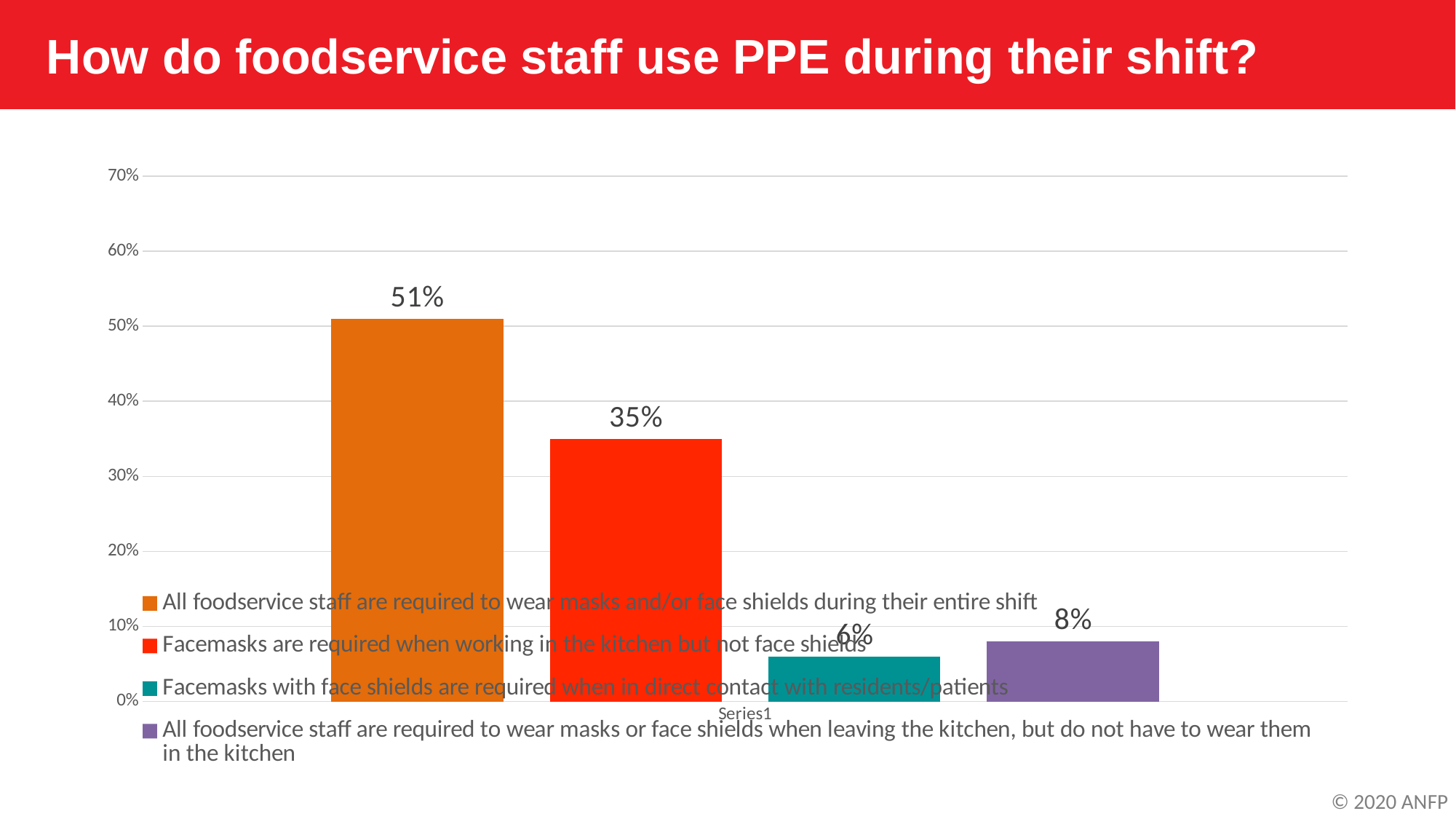
Is the value for 'Facemasks are required when working in the kitchen but not face shields' greater or less than 30%? greater What percentage of respondents said all foodservice staff are required to wear masks and/or face shields during their entire shift? 51% Which PPE practice has the lowest percentage? Facemasks with face shields are required when in direct contact with residents/patients What percentage of respondents said facemasks with face shields are required when in direct contact with residents/patients? 6% What colour is the bar for 'Facemasks with face shields are required when in direct contact with residents/patients'? Teal What percentage of respondents said all foodservice staff are required to wear masks or face shields when leaving the kitchen, but do not have to wear them in the kitchen? 8% What percentage of respondents said facemasks are required when working in the kitchen but not face shields? 35% Which PPE practice has the highest percentage? All foodservice staff are required to wear masks and/or face shields during their entire shift Which is larger: the percentage for masks required when leaving the kitchen only, or the percentage for facemasks with face shields in direct contact with residents/patients? Masks required when leaving the kitchen only (8%) What type of chart is shown on the slide? Bar chart What is the difference in percentage points between the 'entire shift' bar and the 'kitchen but not face shields' bar? 16 How many bars are shown in the chart? 4